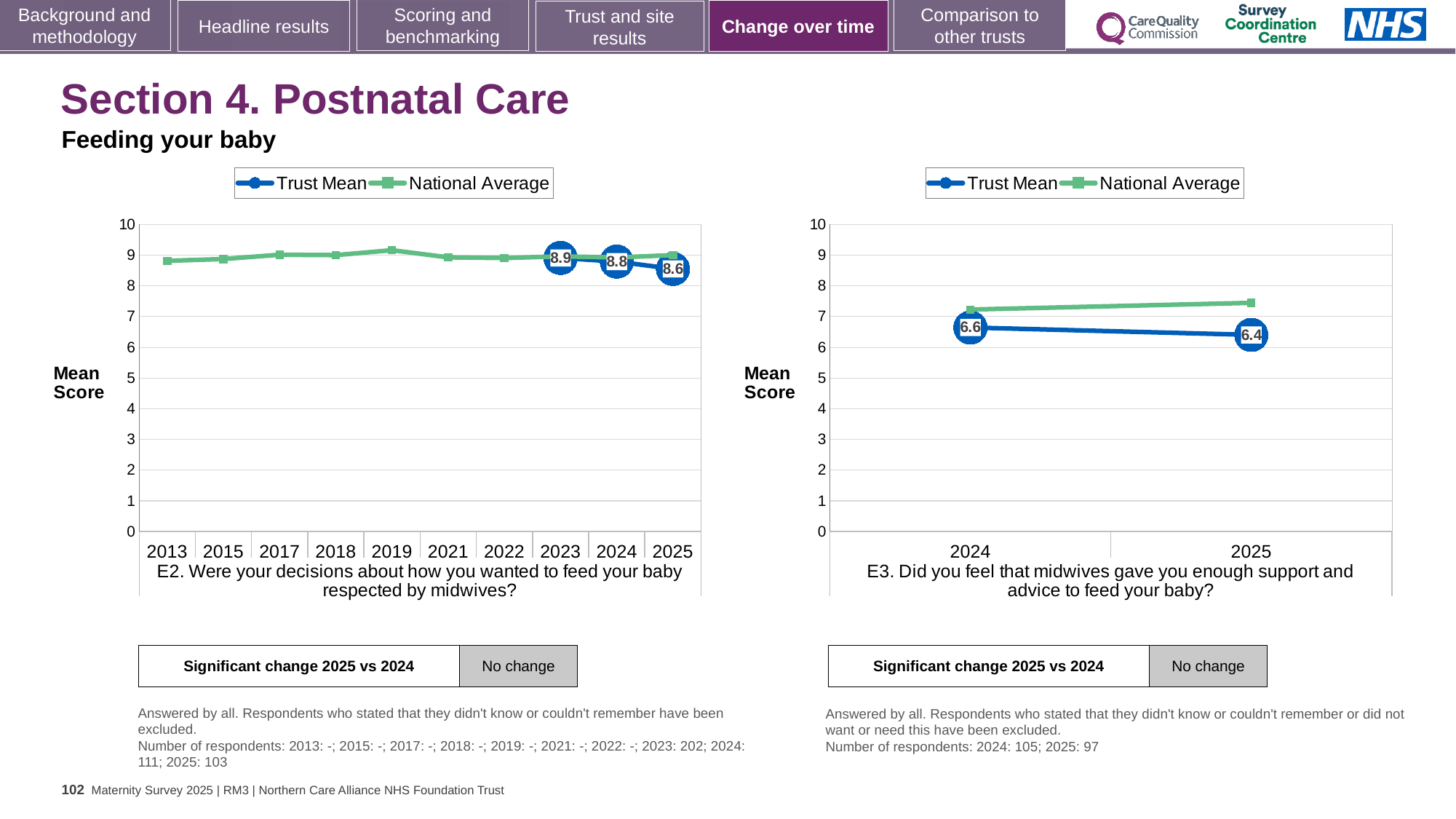
In the right chart (E3), what is the Trust Mean for 2024? 6.6 In the left chart (E2), what is the Trust Mean for 2023? 8.9 In the right chart (E3), what is the Trust Mean for 2025? 6.4 In the left chart (E2), what is the Trust Mean for 2025? 8.6 How many series does the legend of the right chart (E3) list? 2 What kind of chart is the left chart (E2)? Line chart In the right chart (E3), is the National Average for 2025 greater or less than 7? greater In the left chart (E2), which year has the lowest labelled Trust Mean? 2025 How many years are shown on the x axis of the left chart (E2)? 10 In the left chart (E2), what is the difference between the Trust Mean in 2023 and in 2025? 0.3 In the right chart (E3), by how much did the Trust Mean change from 2024 to 2025? 0.2 In the right chart (E3), which is higher in 2025, the Trust Mean or the National Average? National Average